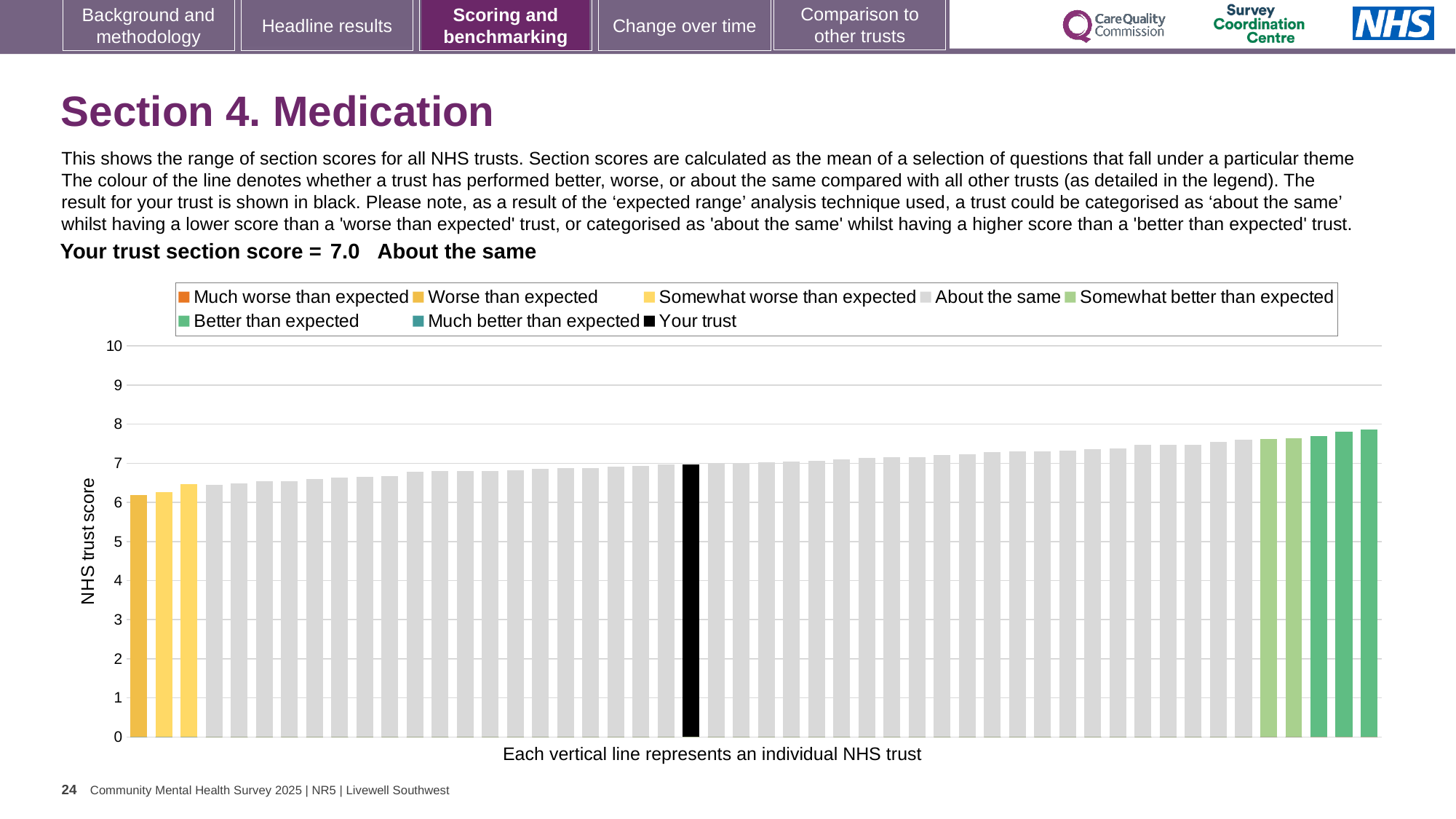
How many bars are coloured green (somewhat better or better than expected) in the chart? 5 Is the value of the black 'Your trust' bar greater or less than 5? greater What kind of chart is shown on the slide? bar chart Is the value of the shortest bar in the chart greater or less than 7? less What is the label on the vertical axis of the chart? NHS trust score Which category does your trust fall into for this section, according to the slide? About the same How many entries does the chart legend list? 8 How many bars are coloured yellow (worse than expected) in the chart? 3 What is the section score for your trust, as stated on the slide? 7.0 Is the value of the tallest bar in the chart greater or less than 8? less Do the bar values rise or fall from left to right across the chart? rise What colour is the bar representing your trust in the chart? black